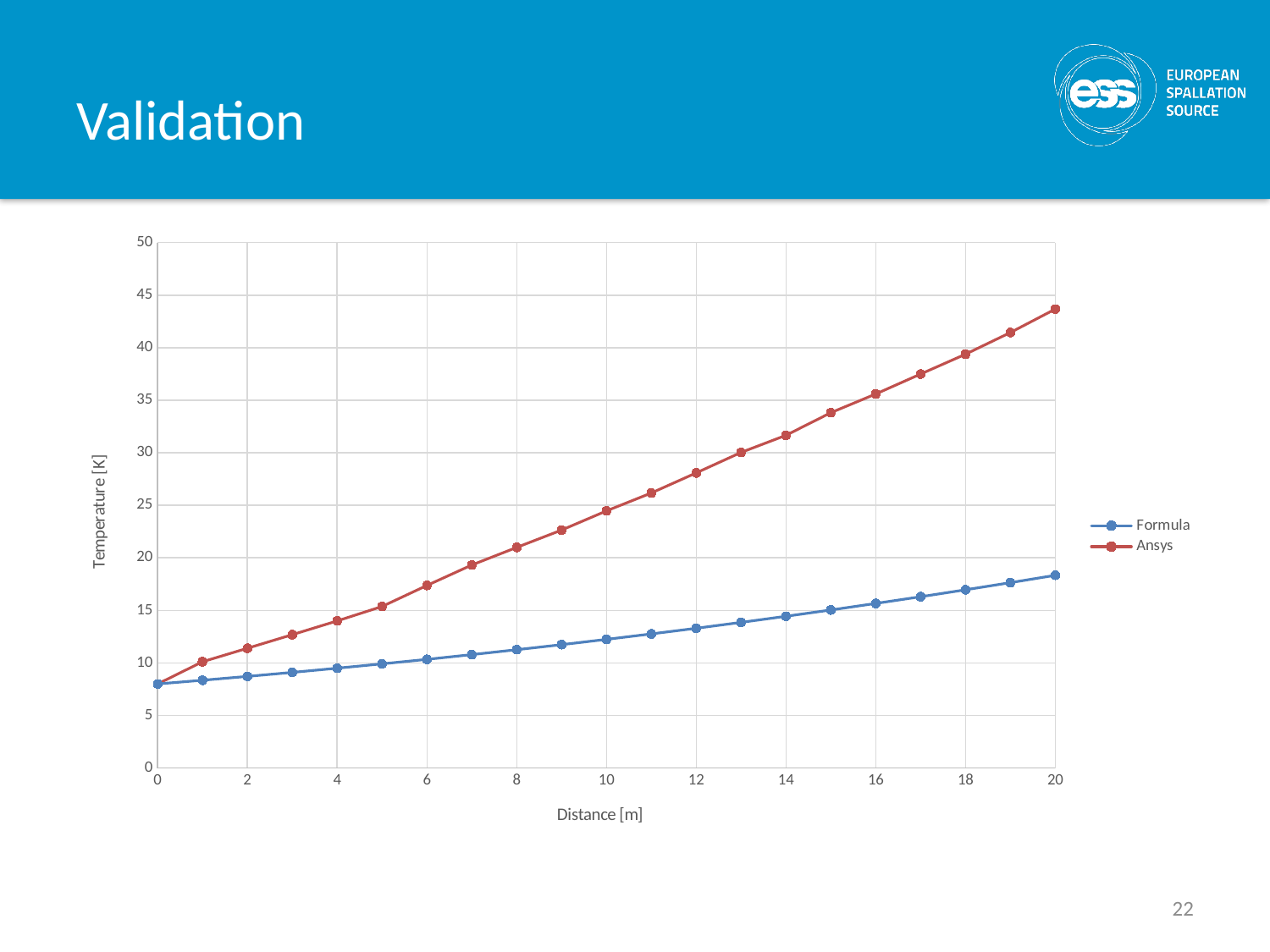
What kind of chart is shown on the slide? Line chart Is the Ansys value at a distance of 6 m greater or less than 20? less At a distance of 20 m, which series has the higher temperature, Formula or Ansys? Ansys Do the Formula values rise or fall as distance increases? Rise How many data points does the Ansys series have? 21 What is the label of the y axis? Temperature [K] Which two series are listed in the legend? Formula and Ansys How many series does the legend list? 2 Do the Ansys values rise or fall as distance increases? Rise Is the Ansys value at a distance of 20 m greater or less than 40? greater Is the Formula value at a distance of 10 m greater or less than 10? greater